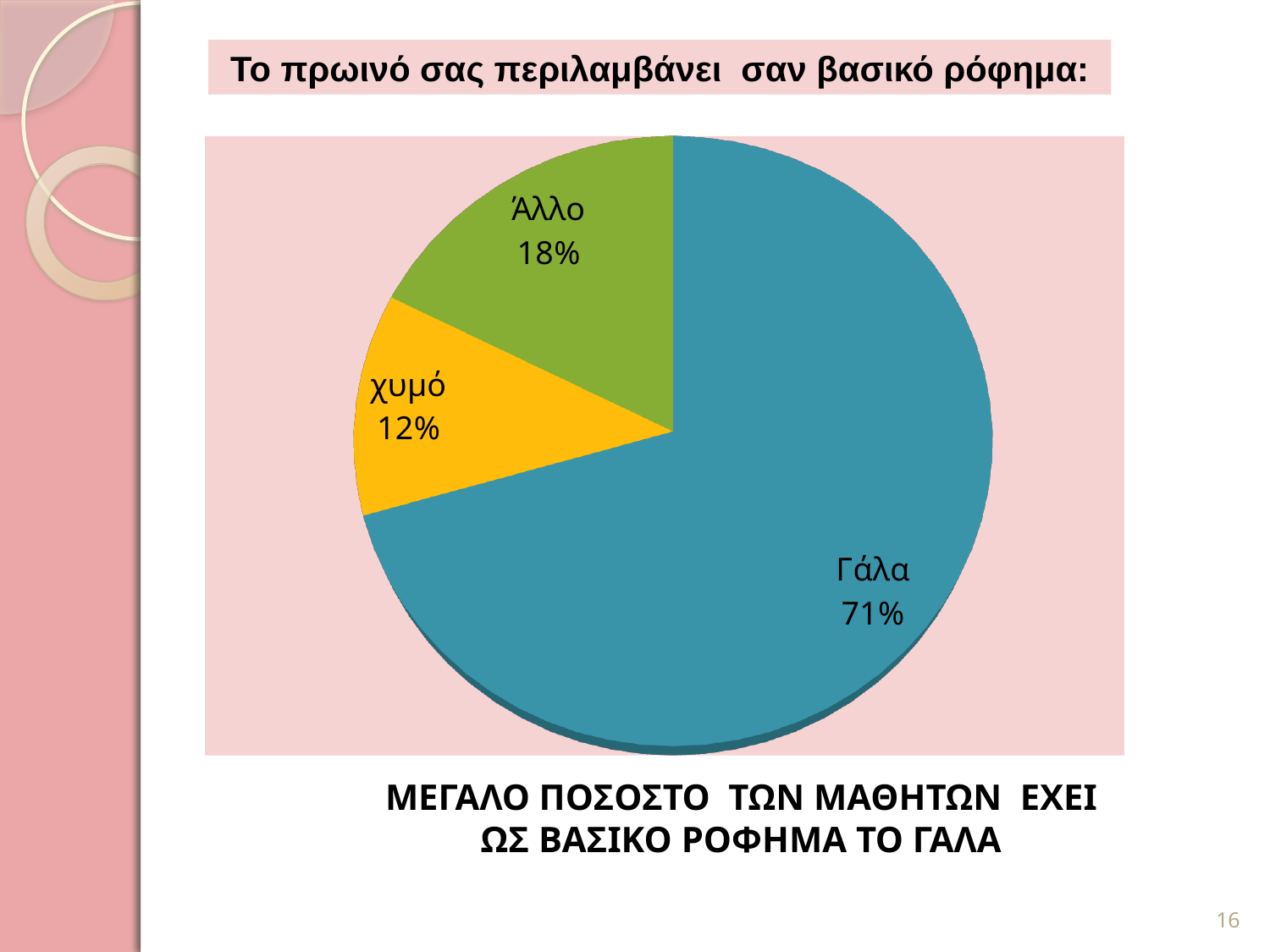
What is the difference in percentage points between Άλλο and χυμό? 6 What is the difference in percentage points between Γάλα and Άλλο? 53 What colour is the slice for Γάλα? Blue What share of the pie does Άλλο represent? 18% Which category has the largest slice of the pie? Γάλα What kind of chart is shown on the slide? Pie chart How many categories are shown in the pie chart? 3 What share of the pie does Γάλα represent? 71% Which is larger, the share for Άλλο or the share for χυμό? Άλλο What share of the pie does χυμό represent? 12% Which category has the smallest slice of the pie? χυμό What is the title of the chart? Το πρωινό σας περιλαμβάνει σαν βασικό ρόφημα: